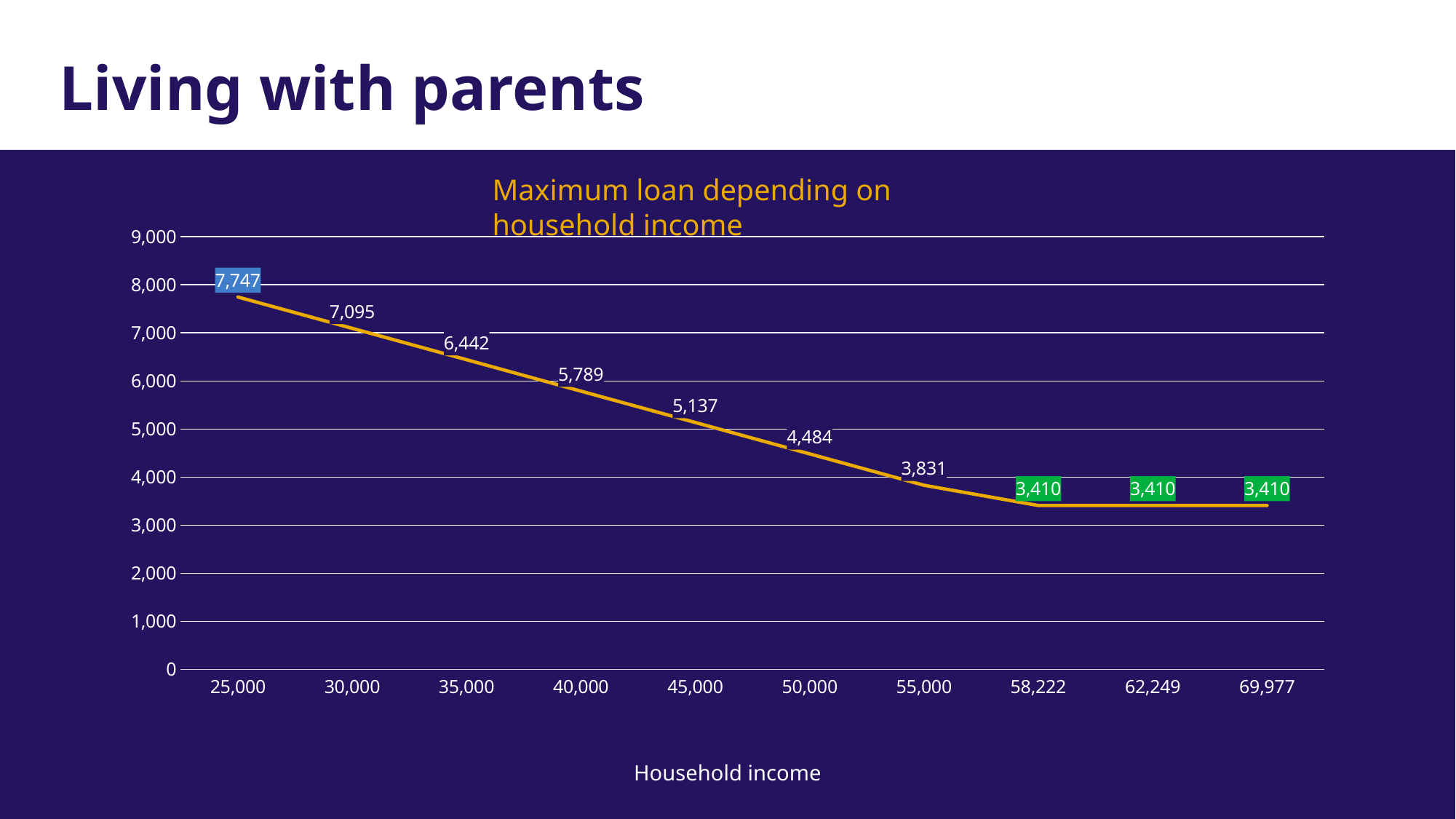
What is the maximum loan at a household income of 69,977? 3,410 Does the maximum loan rise or fall as household income increases? fall What is the maximum loan at a household income of 55,000? 3,831 What is the lowest maximum loan value shown on the chart? 3,410 What is the maximum loan at a household income of 40,000? 5,789 Which is larger, the maximum loan at 45,000 or at 50,000 household income? 45,000 What is the difference between the maximum loan at 25,000 and at 30,000 household income? 652 How many household income points are plotted on the chart? 10 What is the maximum loan at a household income of 25,000? 7,747 At which household income is the maximum loan highest? 25,000 What kind of chart is shown on the slide? line chart What is the title of the chart? Maximum loan depending on household income